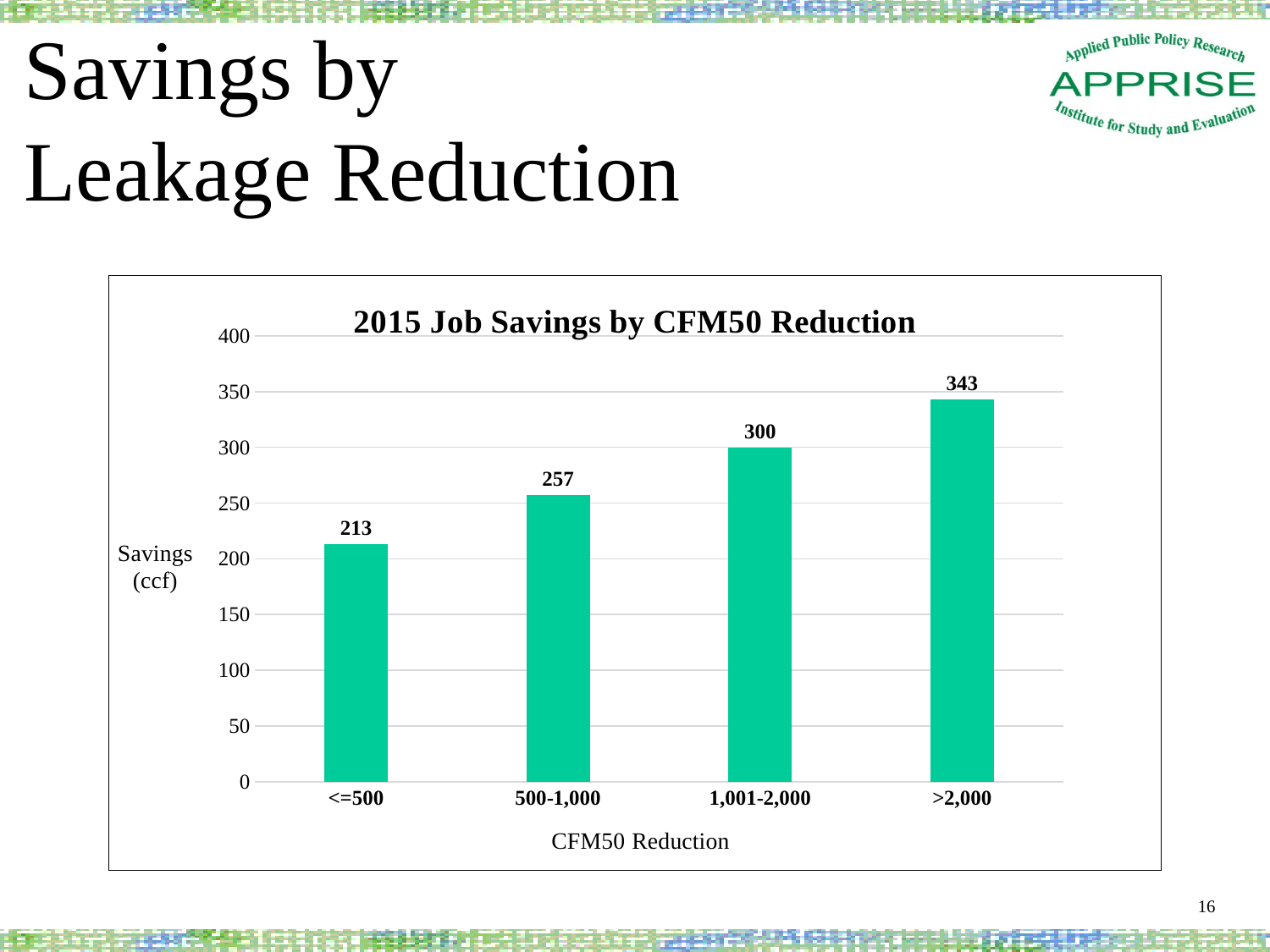
Which has larger savings, the 500-1,000 category or the 1,001-2,000 category? 1,001-2,000 What kind of chart is shown on the slide? Bar chart Which CFM50 reduction category has the lowest savings? <=500 What is the difference in savings between the >2,000 and <=500 categories? 130 Do the savings values rise or fall as the CFM50 reduction increases along the x axis? Rise Which CFM50 reduction category has the highest savings? >2,000 What is the savings value for the <=500 CFM50 reduction category? 213 How many CFM50 reduction categories are shown in the chart? 4 What is the savings value for the >2,000 CFM50 reduction category? 343 What is the savings value for the 500-1,000 CFM50 reduction category? 257 What is the difference in savings between the 1,001-2,000 and 500-1,000 categories? 43 What is the savings value for the 1,001-2,000 CFM50 reduction category? 300